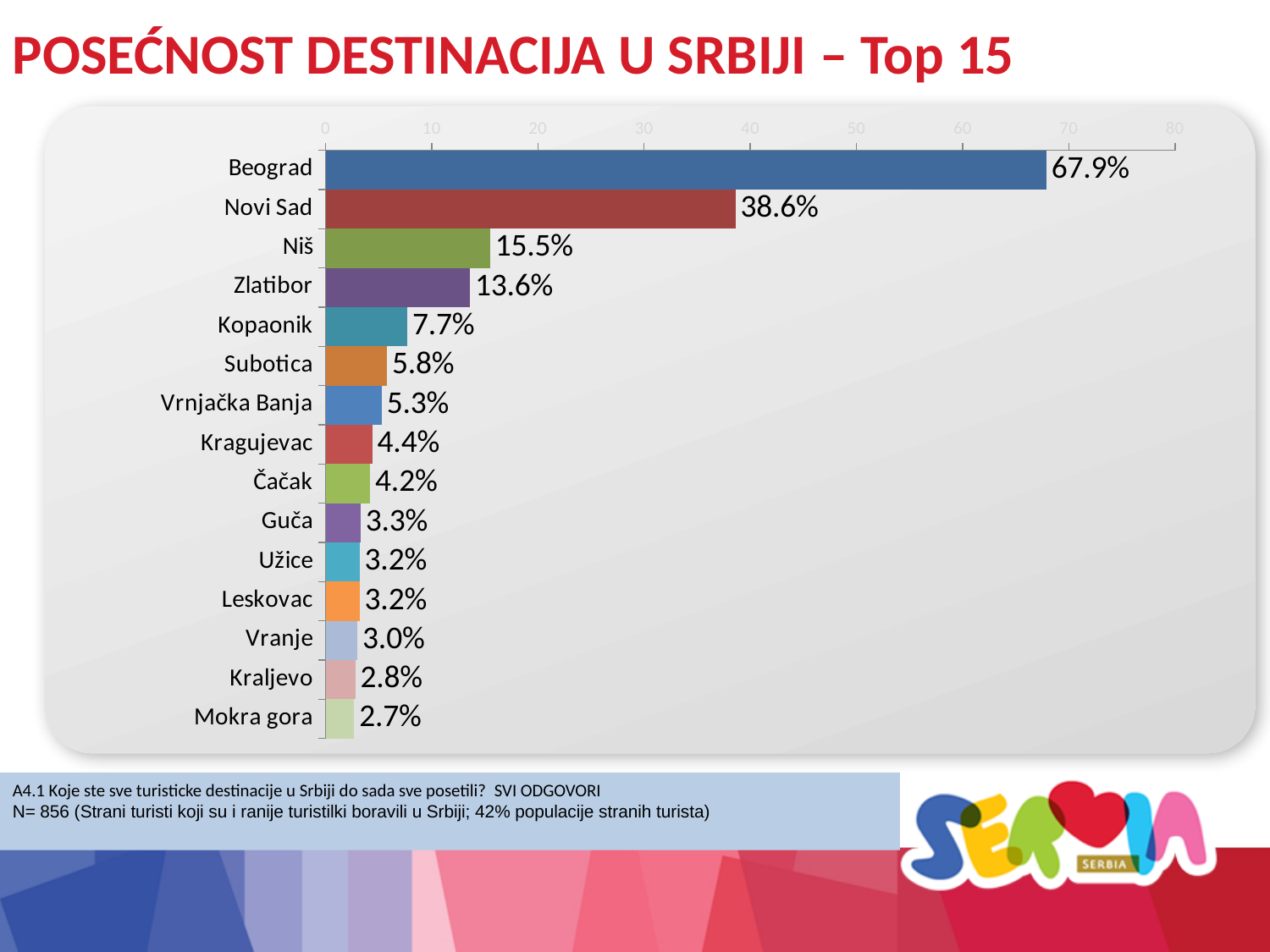
What is the title of the slide? POSEĆNOST DESTINACIJA U SRBIJI – Top 15 What is the value for Zlatibor? 13.6% How many destinations are shown in the chart? 15 What is the difference between the values for Beograd and Novi Sad? 29.3% Which destination has the highest value? Beograd What is the value for Vrnjačka Banja? 5.3% Is the value for Novi Sad greater or less than 30? greater Which has a larger value, Kopaonik or Subotica? Kopaonik What is the value for Beograd? 67.9% What kind of chart is shown on the slide? bar chart What is the difference between the values for Niš and Zlatibor? 1.9% Which destination has the lowest value? Mokra gora